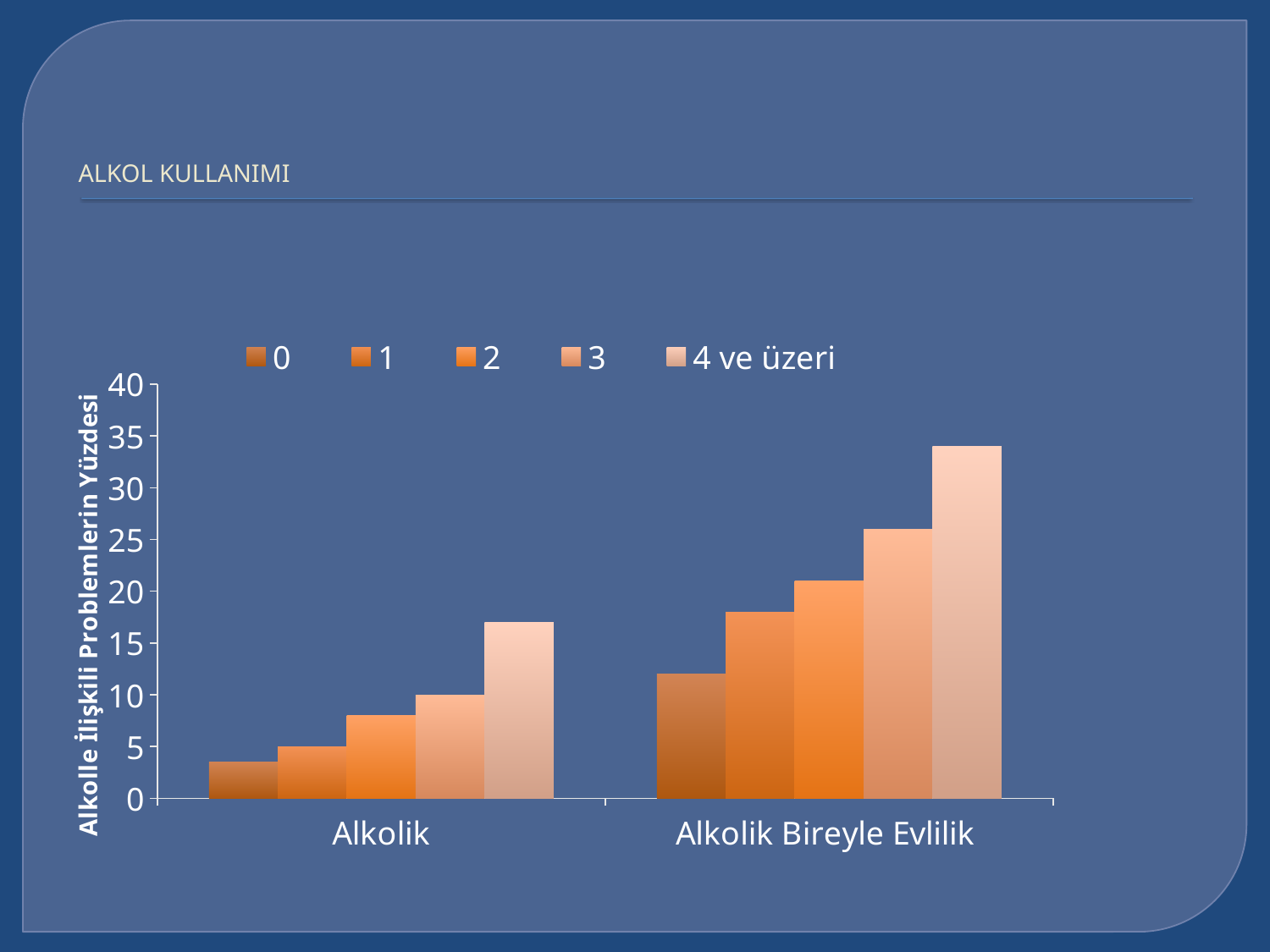
Is the value for the 4 ve üzeri series in the Alkolik Bireyle Evlilik category greater or less than 30? greater How many series does the legend list? 5 What is the label of the last series in the legend? 4 ve üzeri Is the value for the 0 series in the Alkolik Bireyle Evlilik category greater or less than 10? greater Which series has the highest value in the Alkolik Bireyle Evlilik category? 4 ve üzeri Which is larger: the 4 ve üzeri value for Alkolik or the 0 value for Alkolik Bireyle Evlilik? 4 ve üzeri value for Alkolik How many categories are shown on the x axis? 2 What is the title of the y axis? Alkolle İlişkili Problemlerin Yüzdesi Which series has the lowest value in the Alkolik category? 0 Is the value for the 2 series in the Alkolik category greater or less than 10? less Within the Alkolik Bireyle Evlilik category, do the values rise or fall from series 0 to series 4 ve üzeri? rise What kind of chart is shown on the slide? bar chart